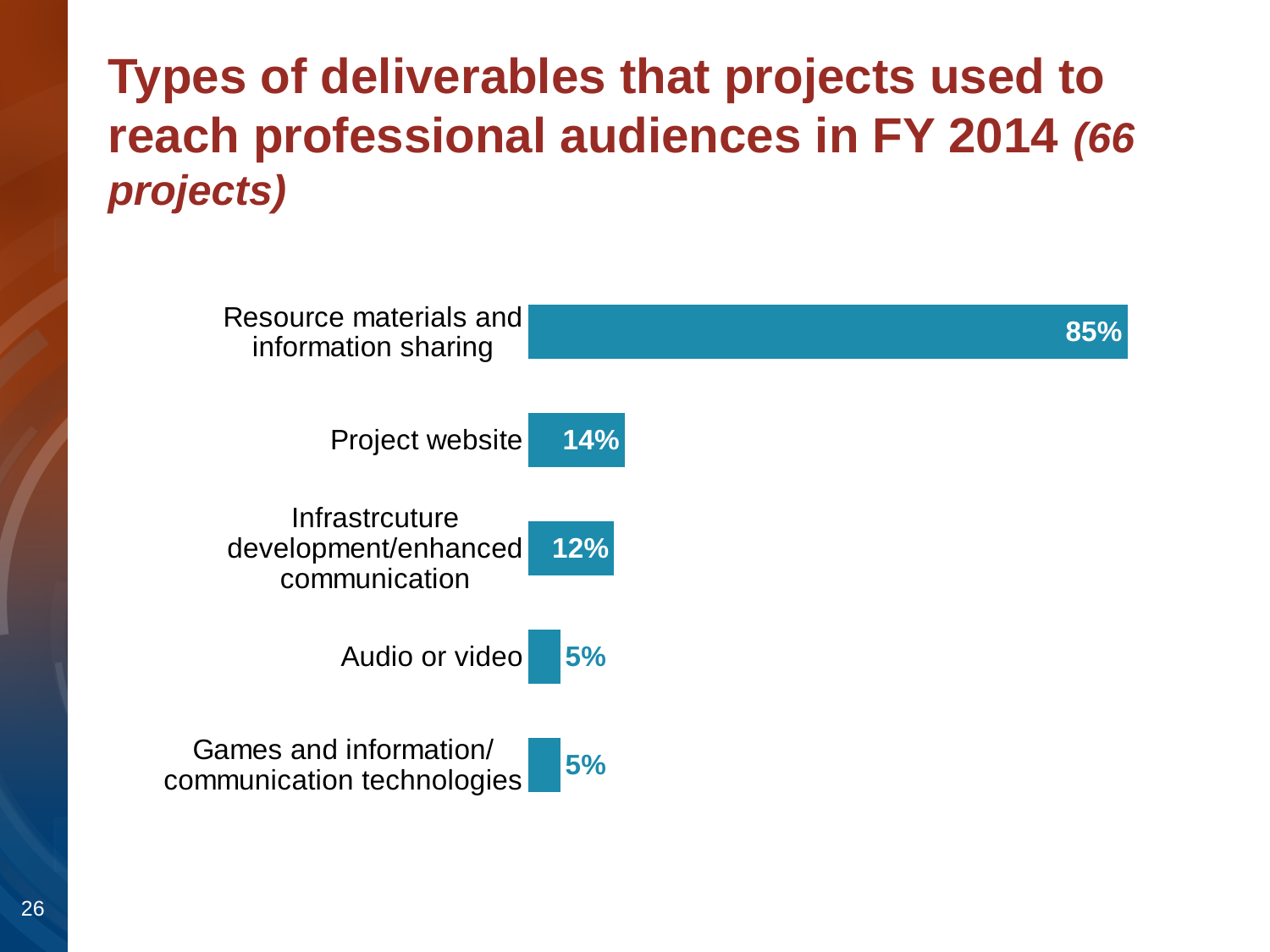
What percentage of projects used resource materials and information sharing to reach professional audiences? 85% How many projects does the slide title say the chart is based on? 66 projects Which two categories share the same value of 5%? Audio or video; Games and information/communication technologies Which is larger, the value for Project website or the value for Audio or video? Project website Which type of deliverable has the highest percentage? Resource materials and information sharing What percentage is shown for Infrastructure development/enhanced communication? 12% How many types of deliverables are shown in the chart? 5 What kind of chart is shown on the slide? Bar chart What is the difference between the values for Project website and Infrastructure development/enhanced communication? 2% What is the difference between the percentages for Resource materials and information sharing and Project website? 71% What is the value for Audio or video? 5% What is the value shown for Project website? 14%